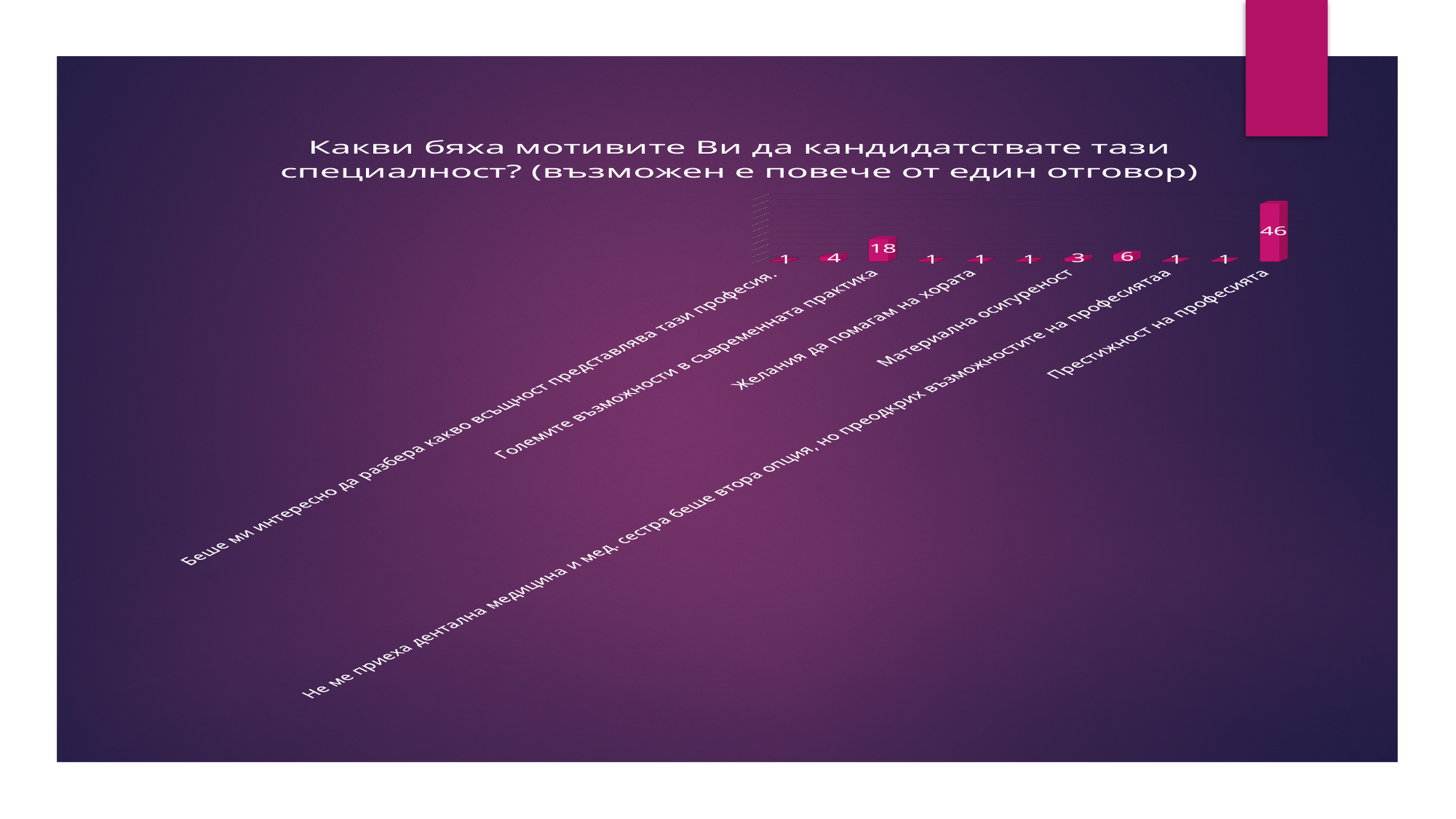
What kind of chart is shown on the slide? Bar chart What is the difference between the values for "Престижност на професията" and "Големите възможности в съвременната практика"? 28 What is the value for "Престижност на професията"? 46 What is the value for "Желания да помагам на хората"? 1 How many bars are plotted in the chart? 11 What is the title of the chart? Какви бяха мотивите Ви да кандидатствате тази специалност? (възможен е повече от един отговор) What is the value for "Големите възможности в съвременната практика"? 18 Which is larger: the value for "Материална осигуреност" or the value for "Големите възможности в съвременната практика"? Големите възможности в съвременната практика What is the difference between the values for "Големите възможности в съвременната практика" and "Материална осигуреност"? 15 What is the value for "Материална осигуреност"? 3 Which category has the highest value? Престижност на професията What is the highest value shown in the chart? 46